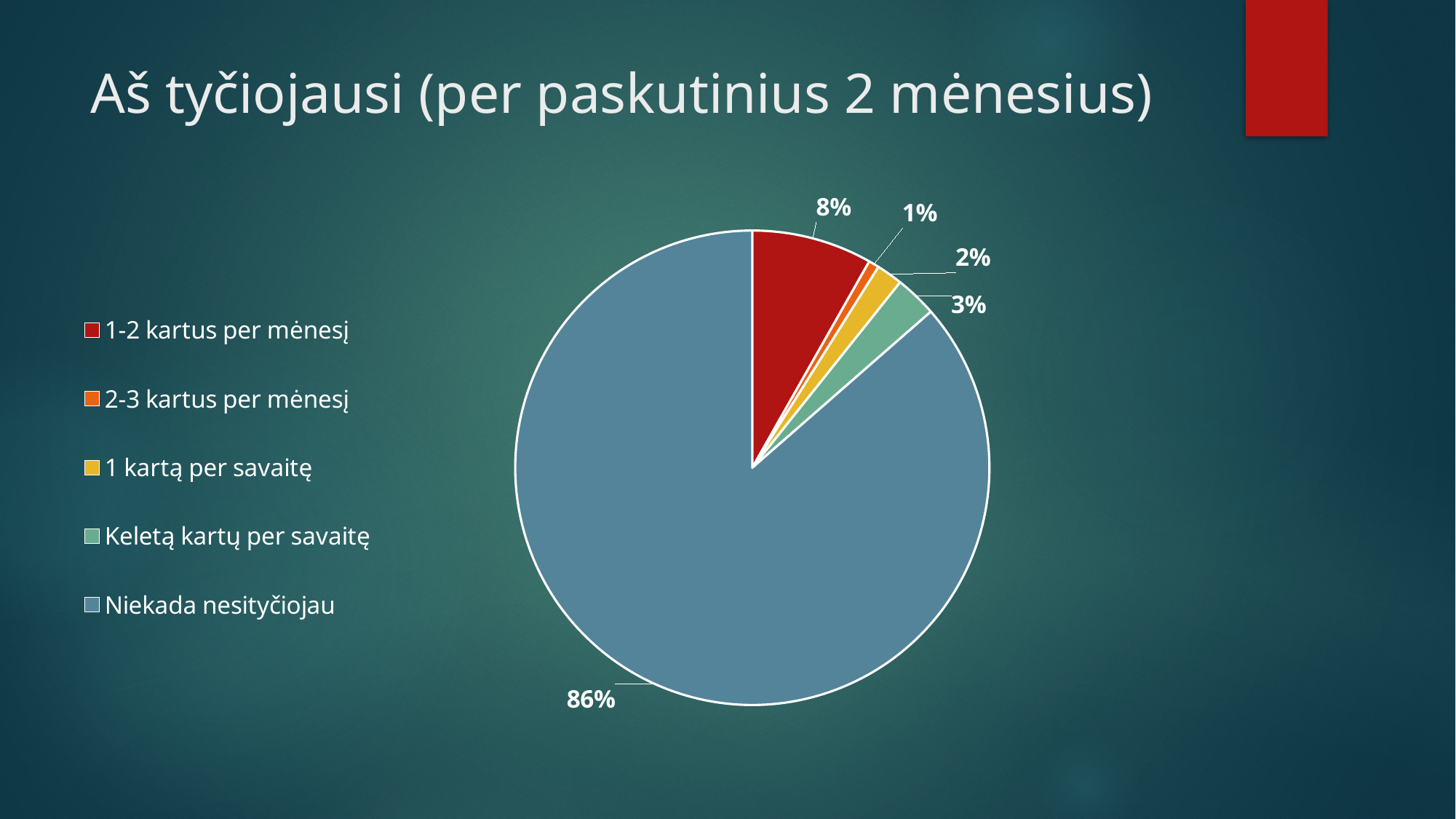
What is the title of the chart? Aš tyčiojausi (per paskutinius 2 mėnesius) Which is larger, the value for 'Keletą kartų per savaitę' or '1 kartą per savaitę'? Keletą kartų per savaitę What kind of chart is shown on the slide? pie chart What share of the pie is 'Niekada nesityčiojau'? 86% What is the value for '1-2 kartus per mėnesį'? 8% What is the difference between the values for 'Niekada nesityčiojau' and '1-2 kartus per mėnesį'? 78% Which category has the smallest slice? 2-3 kartus per mėnesį What is the value for 'Keletą kartų per savaitę'? 3% What is the value for '2-3 kartus per mėnesį'? 1% Which category has the largest slice? Niekada nesityčiojau What is the value for '1 kartą per savaitę'? 2% How many categories does the legend list? 5